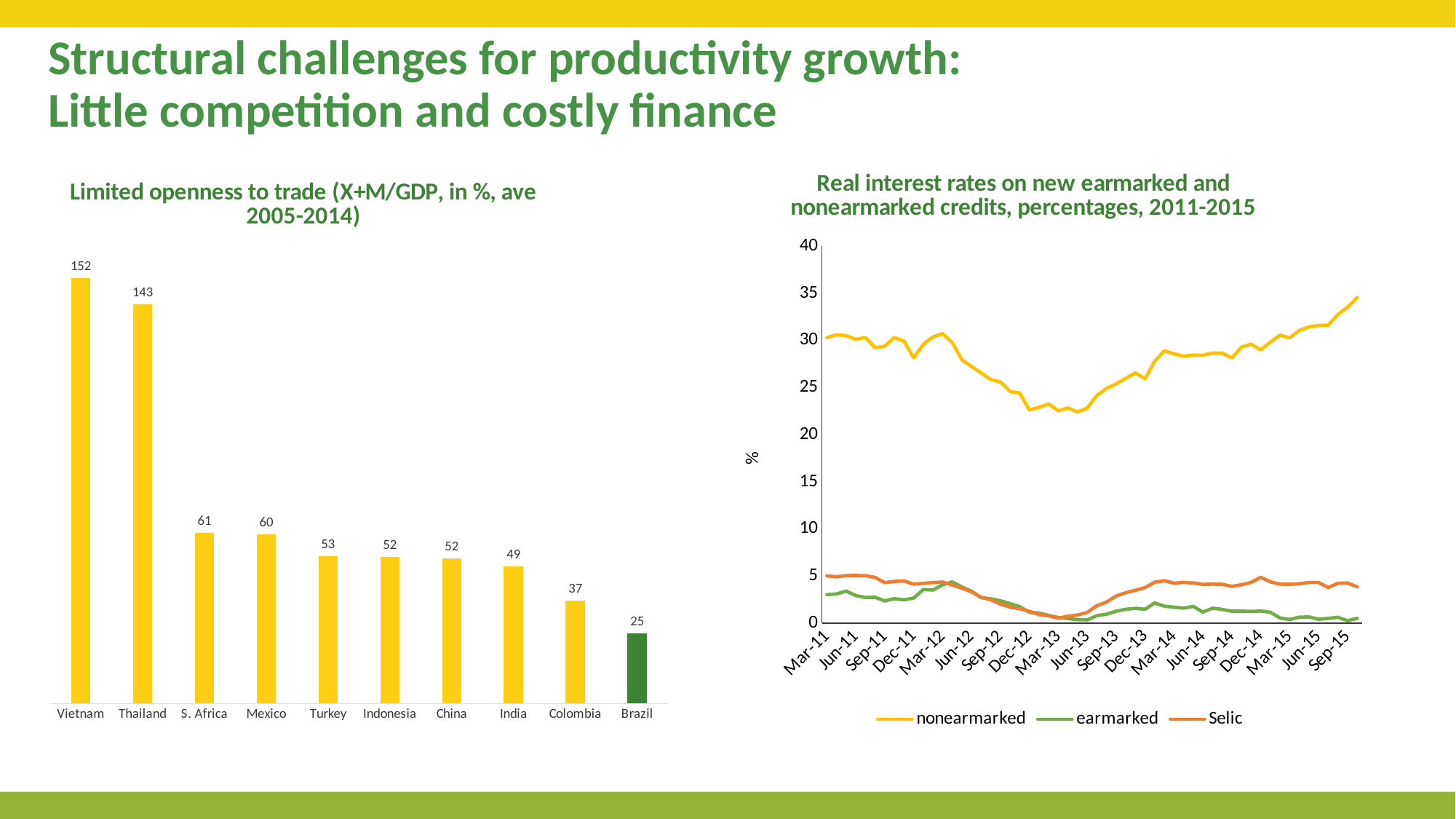
In the 'Limited openness to trade' chart, which country has the highest value? Vietnam How many countries are shown in the 'Limited openness to trade' chart? 10 What kind of chart is the 'Limited openness to trade' chart? Bar chart In the 'Limited openness to trade' chart, what is the value for Vietnam? 152 In the 'Real interest rates' chart, is the nonearmarked value at Sep-15 greater or less than 30? greater In the 'Limited openness to trade' chart, which bar is coloured green rather than yellow? Brazil In the 'Limited openness to trade' chart, which country has the lowest value? Brazil In the 'Limited openness to trade' chart, which is larger, the value for Colombia or the value for India? India In the 'Real interest rates' chart, is the Selic value at Mar-13 greater or less than 5? less In the 'Real interest rates' chart, how many series does the legend list? 3 In the 'Limited openness to trade' chart, what is the value for Brazil? 25 In the 'Limited openness to trade' chart, what is the difference between Vietnam and Thailand? 9